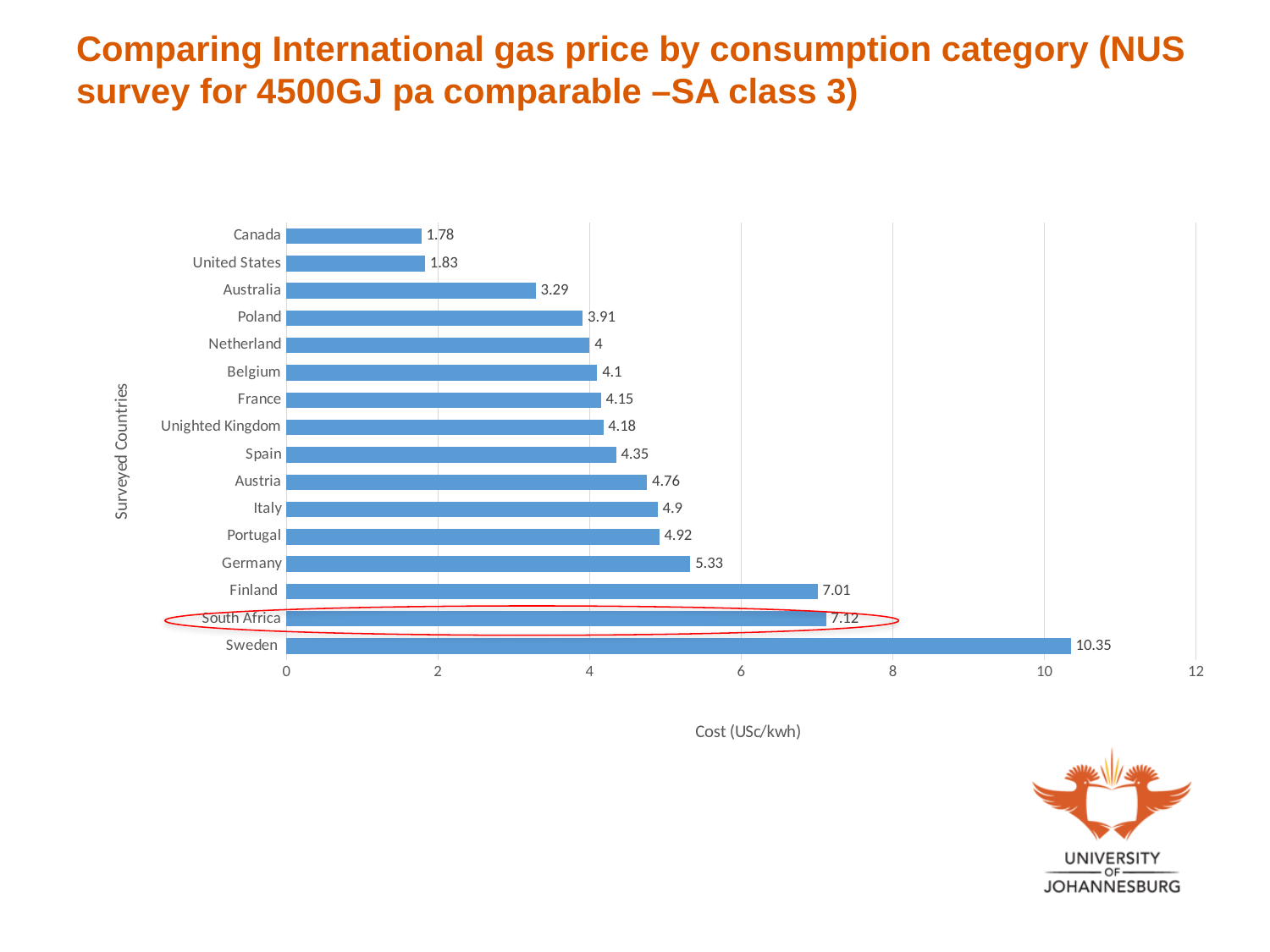
Which country has the lowest cost in the chart? Canada What kind of chart is shown on the slide? Bar chart Which country has the highest cost in the chart? Sweden What is the difference between the cost for Sweden and the cost for South Africa? 3.23 Is the value for Sweden greater or less than 10? greater What is the cost value shown for Canada? 1.78 How many countries are shown in the chart? 16 What is the cost value shown for Germany? 5.33 What is the cost value shown for South Africa? 7.12 What is the difference between the cost for Finland and the cost for Germany? 1.68 What is the label of the horizontal axis? Cost (USc/kwh) Which has a higher cost, Australia or Poland? Poland